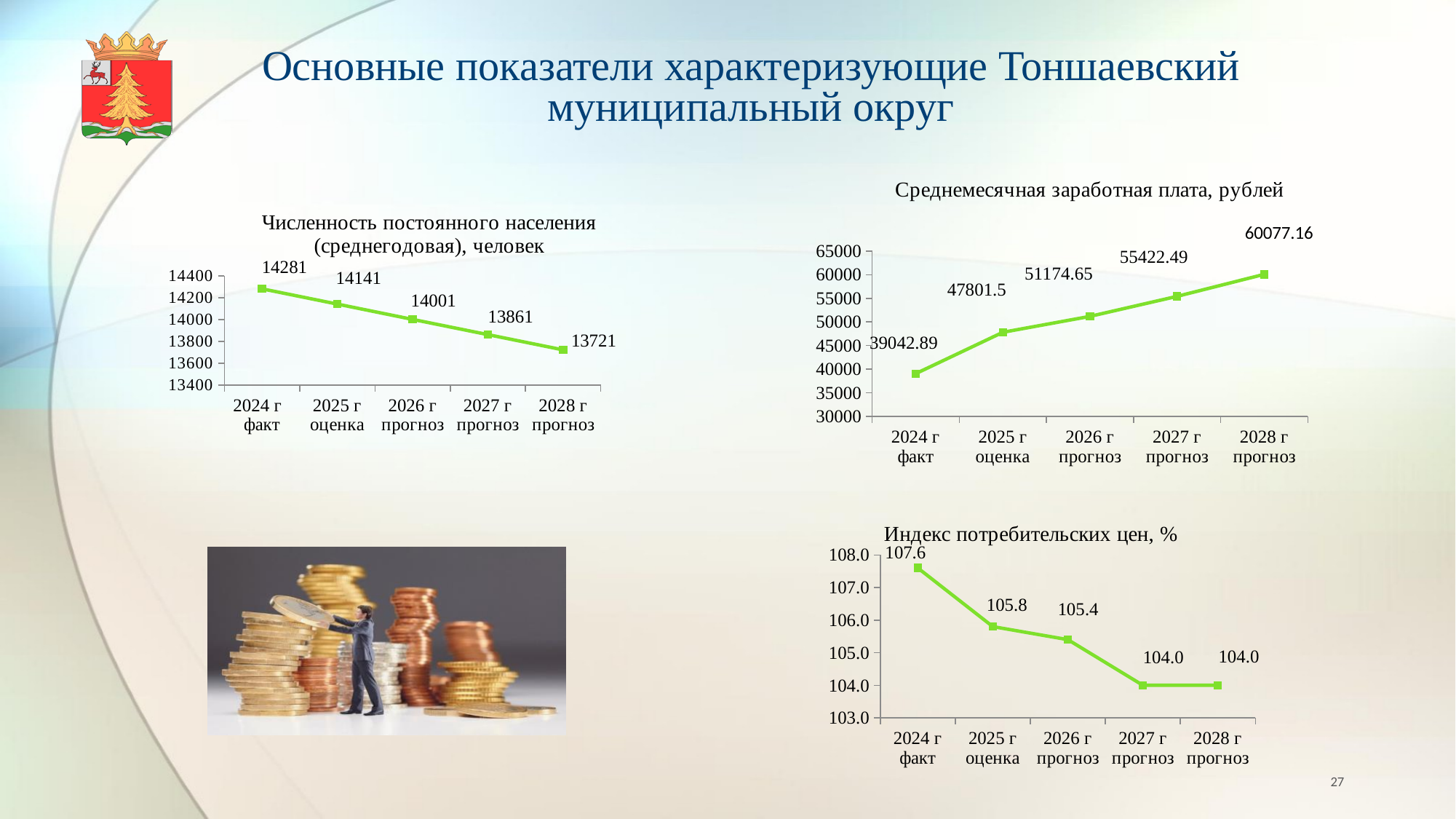
In the chart 'Среднемесячная заработная плата, рублей', what is the value for 2025 г оценка? 47801.5 In the chart 'Среднемесячная заработная плата, рублей', how many data points are plotted? 5 In the chart 'Среднемесячная заработная плата, рублей', which year has the highest value? 2028 г прогноз What type of chart is 'Индекс потребительских цен, %'? line chart In the chart 'Индекс потребительских цен, %', what is the difference between the 2025 г оценка value and the 2026 г прогноз value? 0.4 In the chart 'Численность постоянного населения (среднегодовая), человек', what is the value for 2028 г прогноз? 13721 In the chart 'Индекс потребительских цен, %', which is larger: the value for 2025 г оценка or the value for 2027 г прогноз? 2025 г оценка In the chart 'Среднемесячная заработная плата, рублей', which year has the lowest value? 2024 г факт In the chart 'Численность постоянного населения (среднегодовая), человек', do the values rise or fall from 2024 to 2028? fall In the chart 'Численность постоянного населения (среднегодовая), человек', what is the value for 2024 г факт? 14281 In the chart 'Численность постоянного населения (среднегодовая), человек', what is the difference between the 2024 г факт value and the 2028 г прогноз value? 560 In the chart 'Индекс потребительских цен, %', what is the value for 2024 г факт? 107.6